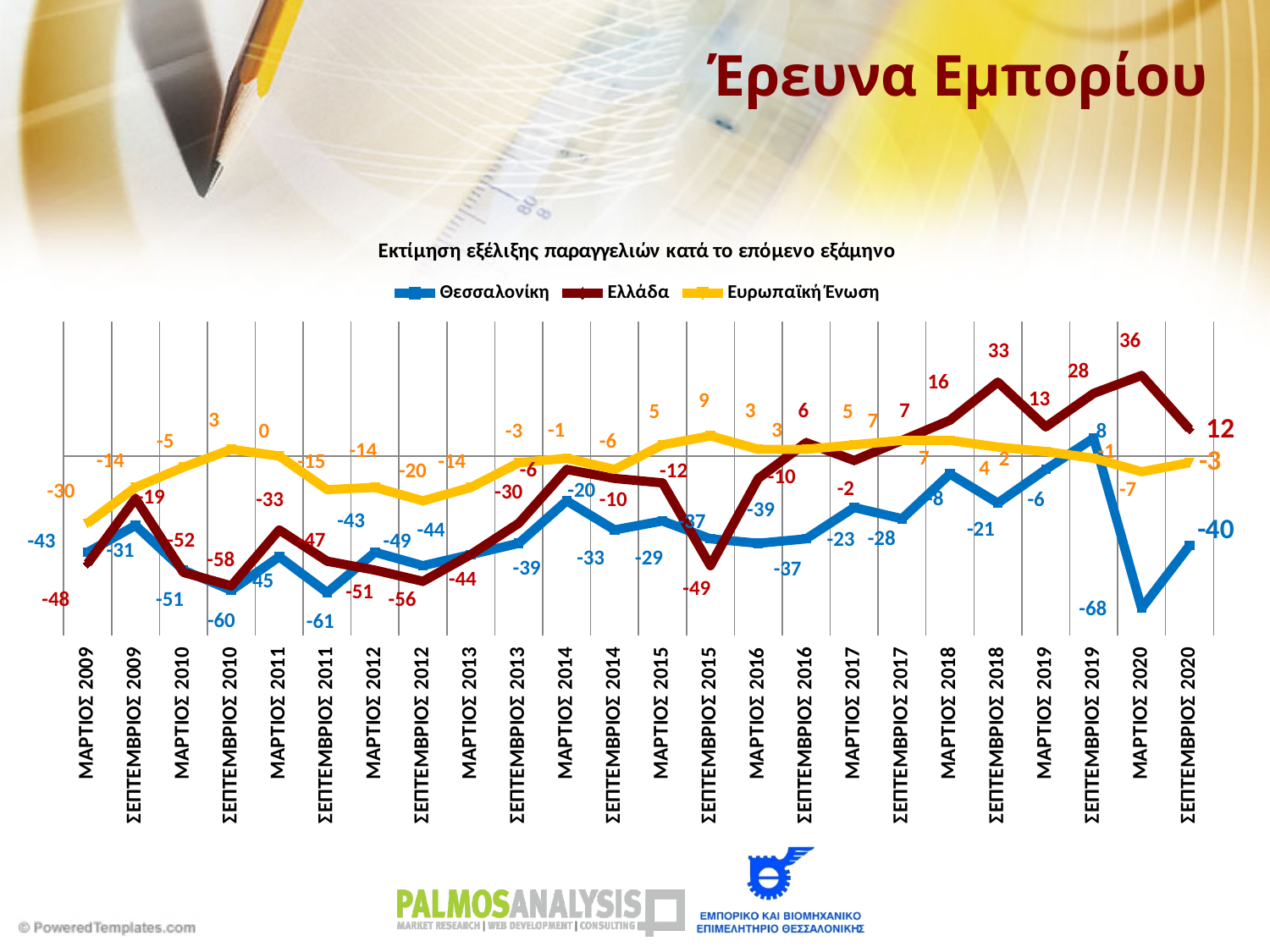
How many series does the legend list? 3 What is the value for Θεσσαλονίκη in ΜΑΡΤΙΟΣ 2020? -68 Does the Θεσσαλονίκη series rise or fall from ΣΕΠΤΕΜΒΡΙΟΣ 2019 to ΜΑΡΤΙΟΣ 2020? fall In which period does Ελλάδα reach its highest value? ΜΑΡΤΙΟΣ 2020 What is the value for Ελλάδα in ΣΕΠΤΕΜΒΡΙΟΣ 2020? 12 In which period does Θεσσαλονίκη reach its lowest value? ΜΑΡΤΙΟΣ 2020 In ΜΑΡΤΙΟΣ 2020, which series has the higher value, Ελλάδα or Θεσσαλονίκη? Ελλάδα What is the value for Ευρωπαϊκή Ένωση in ΣΕΠΤΕΜΒΡΙΟΣ 2020? -3 What is the title of the chart? Εκτίμηση εξέλιξης παραγγελιών κατά το επόμενο εξάμηνο How many time points are plotted along the x axis? 24 What kind of chart is shown on the slide? line chart What is the difference between the Ελλάδα and Θεσσαλονίκη values in ΣΕΠΤΕΜΒΡΙΟΣ 2020? 52